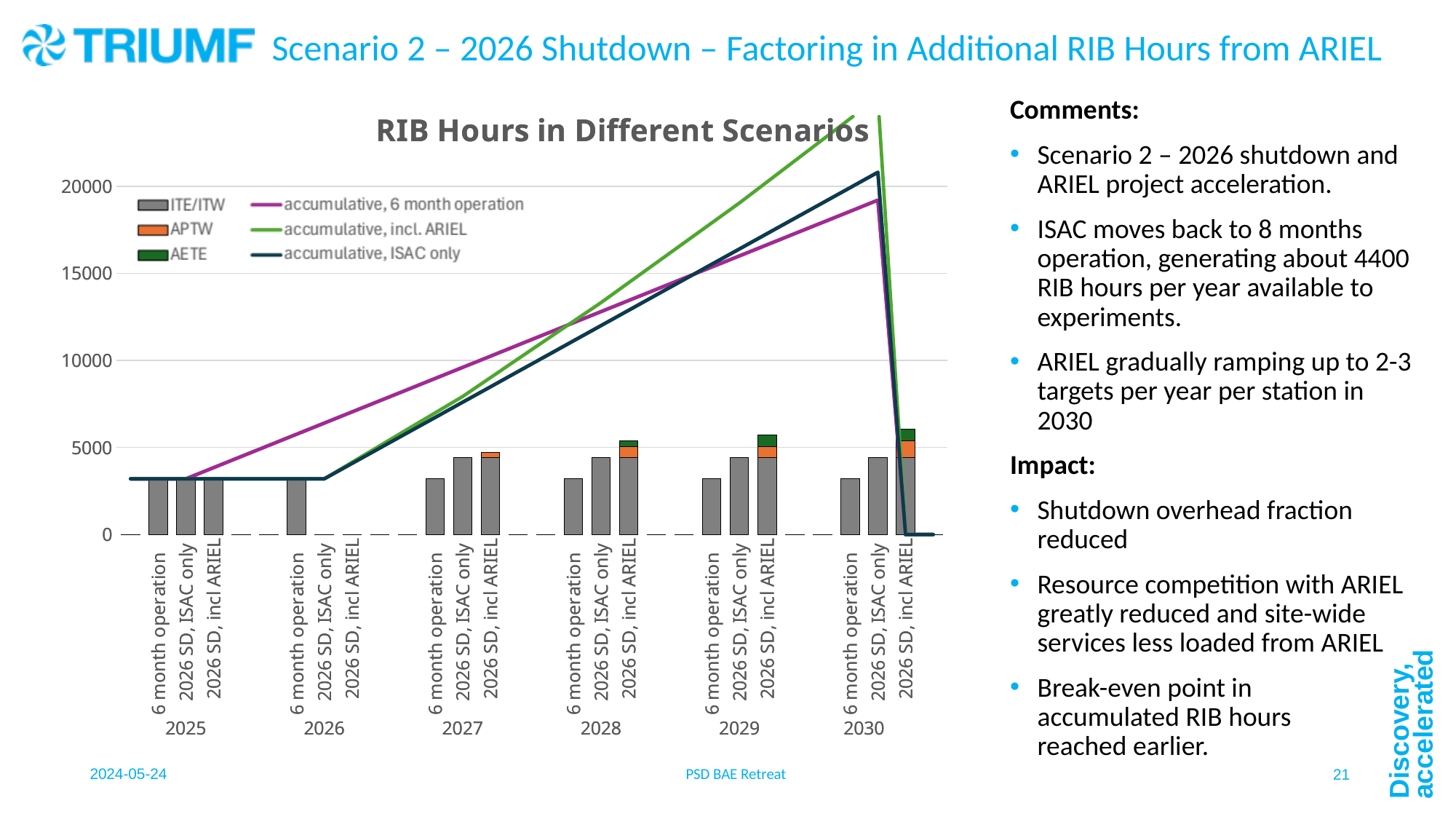
How many bars are plotted for the year 2026? 1 Is the value of the '2026 SD, ISAC only' bar in 2027 greater or less than 5000? less In 2027, which bar is taller: '6 month operation' or '2026 SD, ISAC only'? 2026 SD, ISAC only Which bar series is shown in orange in the legend? APTW Is the total height of the stacked '2026 SD, incl ARIEL' bar in 2030 greater or less than 5000? greater What kind of chart is shown on the slide? A combined bar and line chart In 2028, which of the three bars is the tallest? 2026 SD, incl ARIEL Does the 'accumulative, incl. ARIEL' line rise or fall between 2026 and 2029? rise What is the title of the chart? RIB Hours in Different Scenarios How many series does the chart legend list? 6 Is the value of the '6 month operation' bar in 2025 greater or less than 5000? less How many years are shown along the x axis of the chart? 6